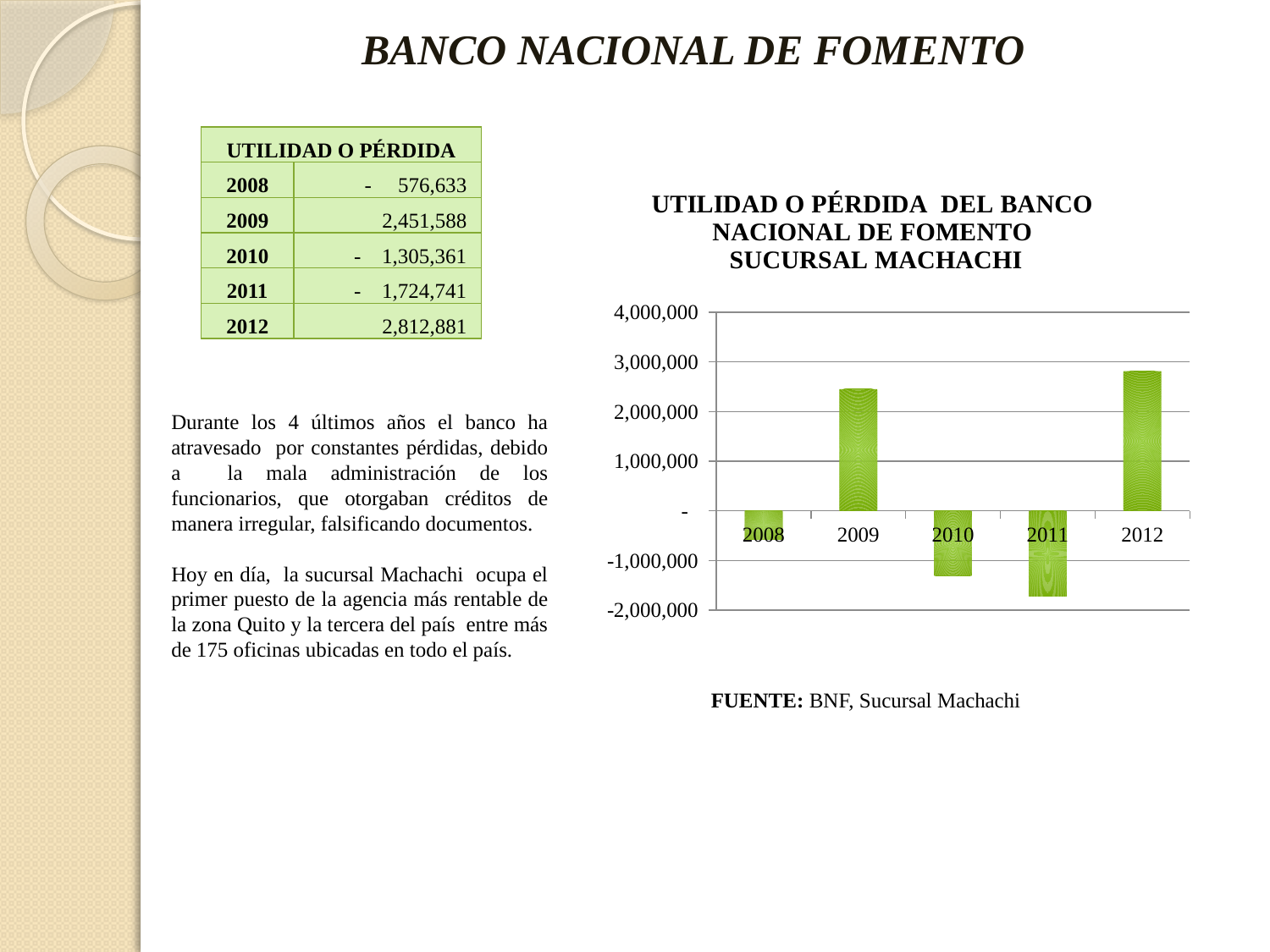
According to the table, what is the utilidad o pérdida for 2009? 2,451,588 How many years are plotted in the chart? 5 According to the table, what is the utilidad o pérdida for 2011? - 1,724,741 According to the table, what is the utilidad o pérdida for 2012? 2,812,881 What kind of chart is shown on the slide? bar chart Which year has the larger value, 2009 or 2012? 2012 Is the value for 2011 greater or less than -1,000,000? less Is the value for 2009 greater or less than 2,000,000? greater What is the title of the chart? UTILIDAD O PÉRDIDA DEL BANCO NACIONAL DE FOMENTO SUCURSAL MACHACHI Which year has the highest value in the chart? 2012 Using the table values, what is the difference between the 2012 and 2009 values? 361,293 Which year has the lowest value in the chart? 2011